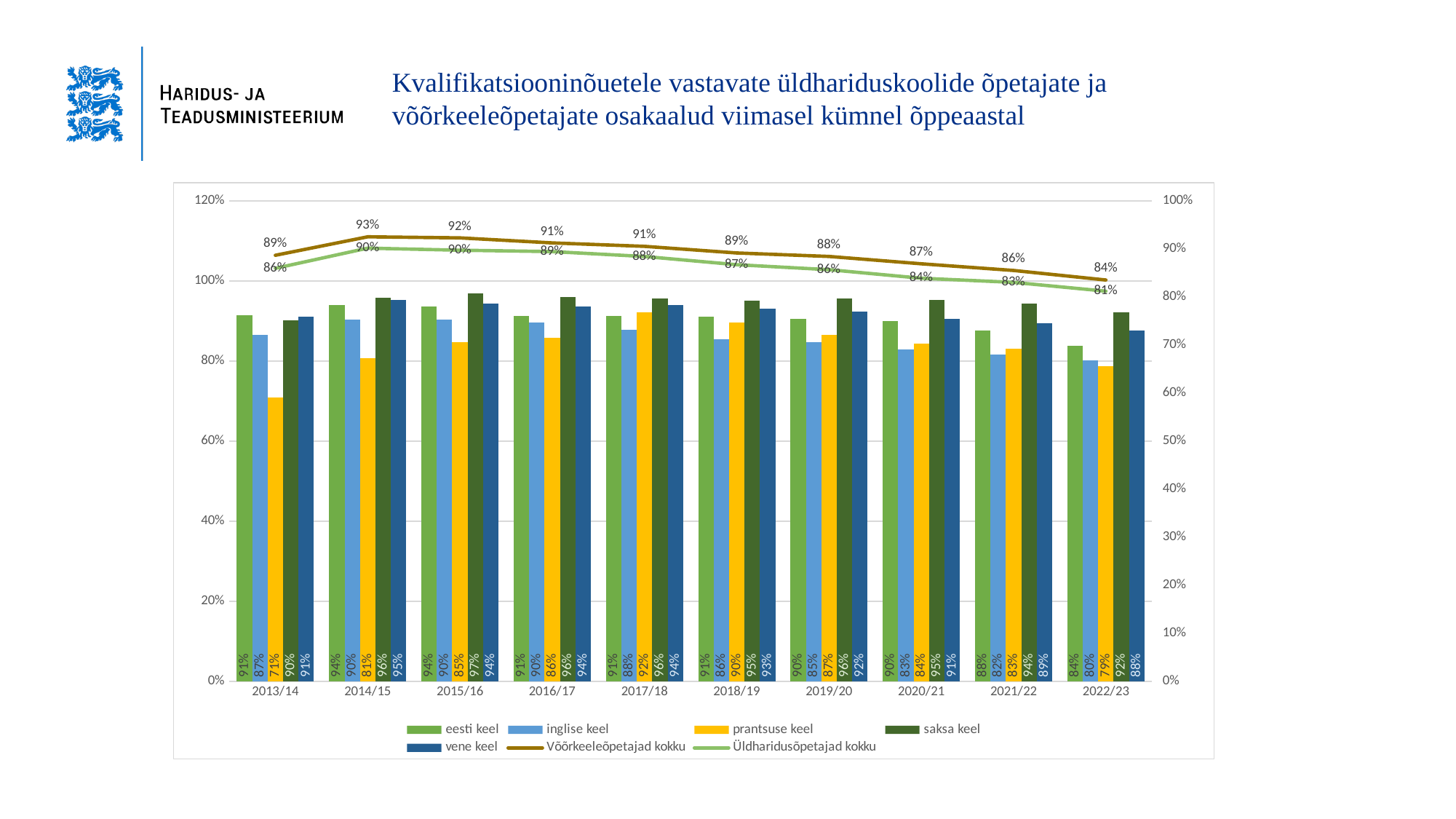
Does the Üldharidusõpetajad kokku line rise or fall from 2015/16 to 2022/23? fall In which school year is the value for prantsuse keel the lowest? 2013/14 Which is larger in 2017/18: the value for prantsuse keel or the value for inglise keel? prantsuse keel What is the difference between the saksa keel and inglise keel values in 2022/23? 12% How many series does the legend list? 7 What is the value of the Võõrkeeleõpetajad kokku line in 2014/15? 93% In which school year is the Võõrkeeleõpetajad kokku line at its highest? 2014/15 How many school years are shown on the x axis? 10 Which series is drawn as a brown line? Võõrkeeleõpetajad kokku What is the value for saksa keel in 2015/16? 97% What is the value for prantsuse keel in 2013/14? 71% What is the value of the Üldharidusõpetajad kokku line in 2022/23? 81%